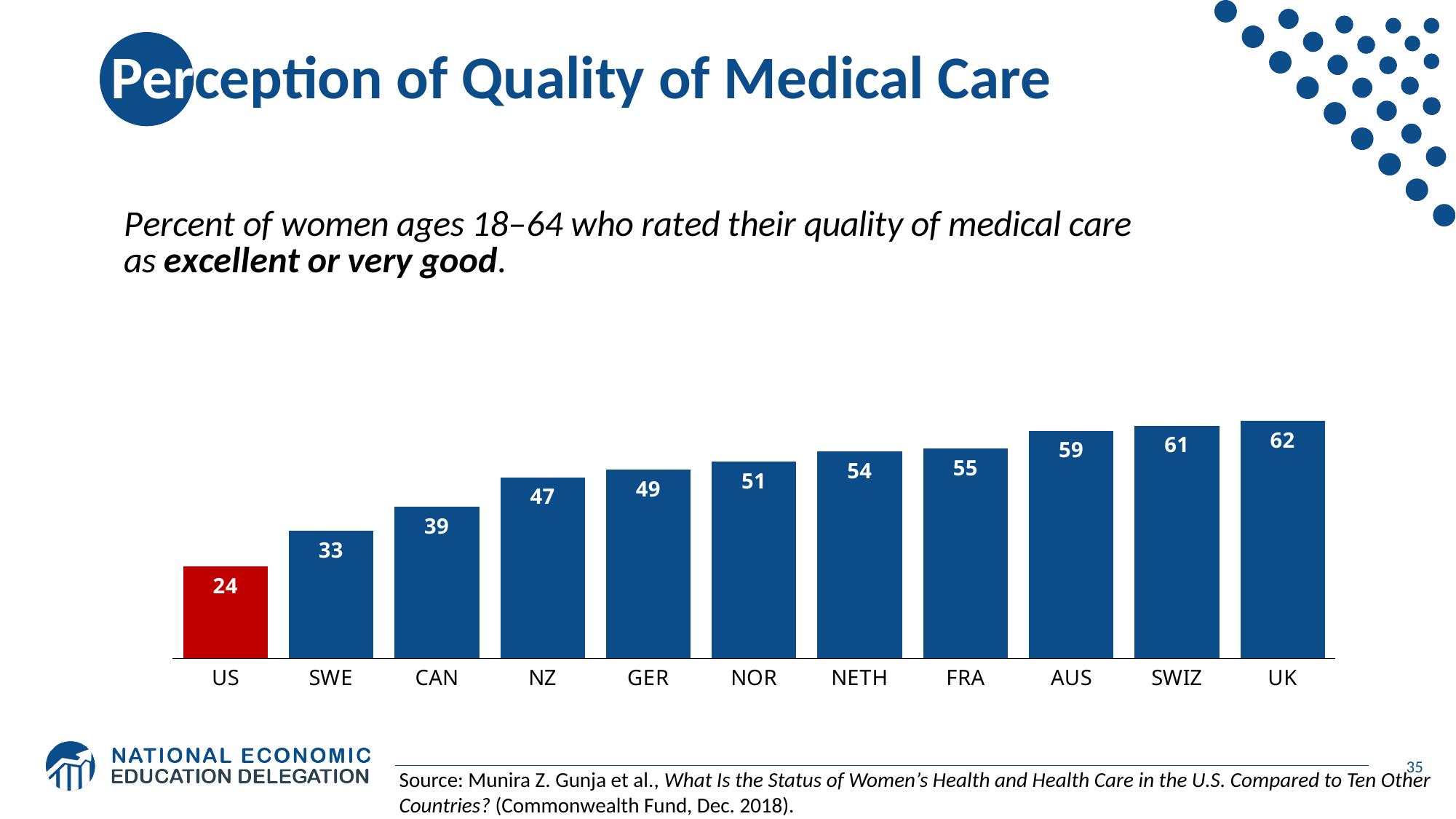
What is the value for GER? 49 Do the values rise or fall from left to right across the countries? rise What is the value for AUS? 59 Which country has the lowest value? US What is the difference between the values for UK and US? 38 Which has a larger value, NOR or NZ? NOR How many countries are shown in the chart? 11 Which country has the highest value? UK Which bar is coloured red instead of blue? US What kind of chart is shown on the slide? bar chart What is the value for the US? 24 What is the difference between the values for CAN and SWE? 6